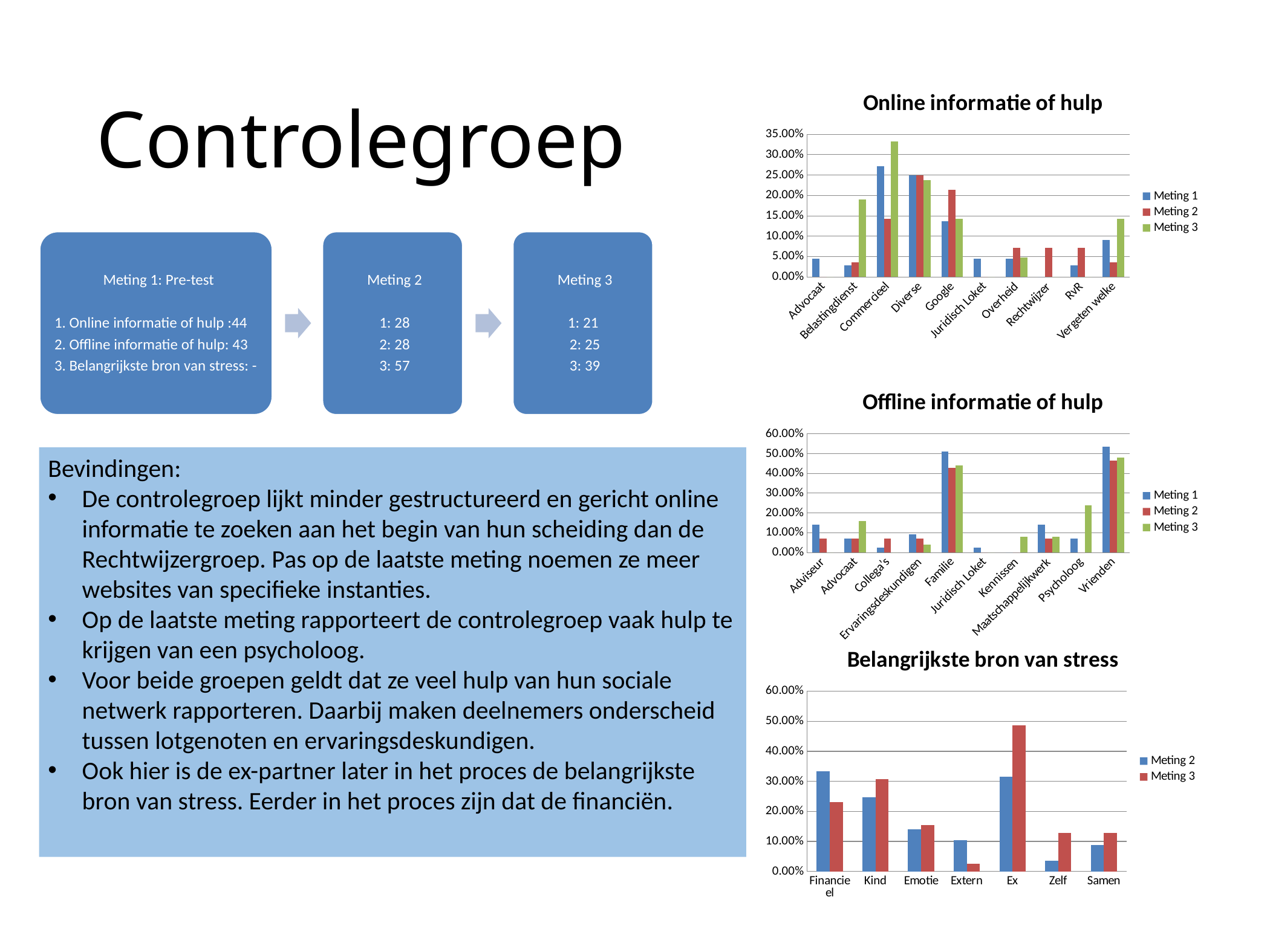
In the 'Belangrijkste bron van stress' chart, which category has the lowest value for Meting 3? Extern What kind of chart is the 'Belangrijkste bron van stress' chart? bar chart In the 'Belangrijkste bron van stress' chart, for Kind, which is larger: Meting 2 or Meting 3? Meting 3 In the 'Online informatie of hulp' chart, which category has the highest value for Meting 3? Commercieel In the 'Belangrijkste bron van stress' chart, how many categories are shown on the x axis? 7 In the 'Belangrijkste bron van stress' chart, which category has the highest value for Meting 3? Ex In the 'Belangrijkste bron van stress' chart, is the Meting 3 value for Ex greater or less than 40.00%? greater In the 'Online informatie of hulp' chart, how many series does the legend list? 3 In the 'Belangrijkste bron van stress' chart, how many series does the legend list? 2 In the 'Offline informatie of hulp' chart, is the Meting 3 value for Psycholoog greater or less than 20.00%? greater In the 'Online informatie of hulp' chart, for Google, which is larger: Meting 1 or Meting 2? Meting 2 In the 'Offline informatie of hulp' chart, how many categories are shown on the x axis? 10